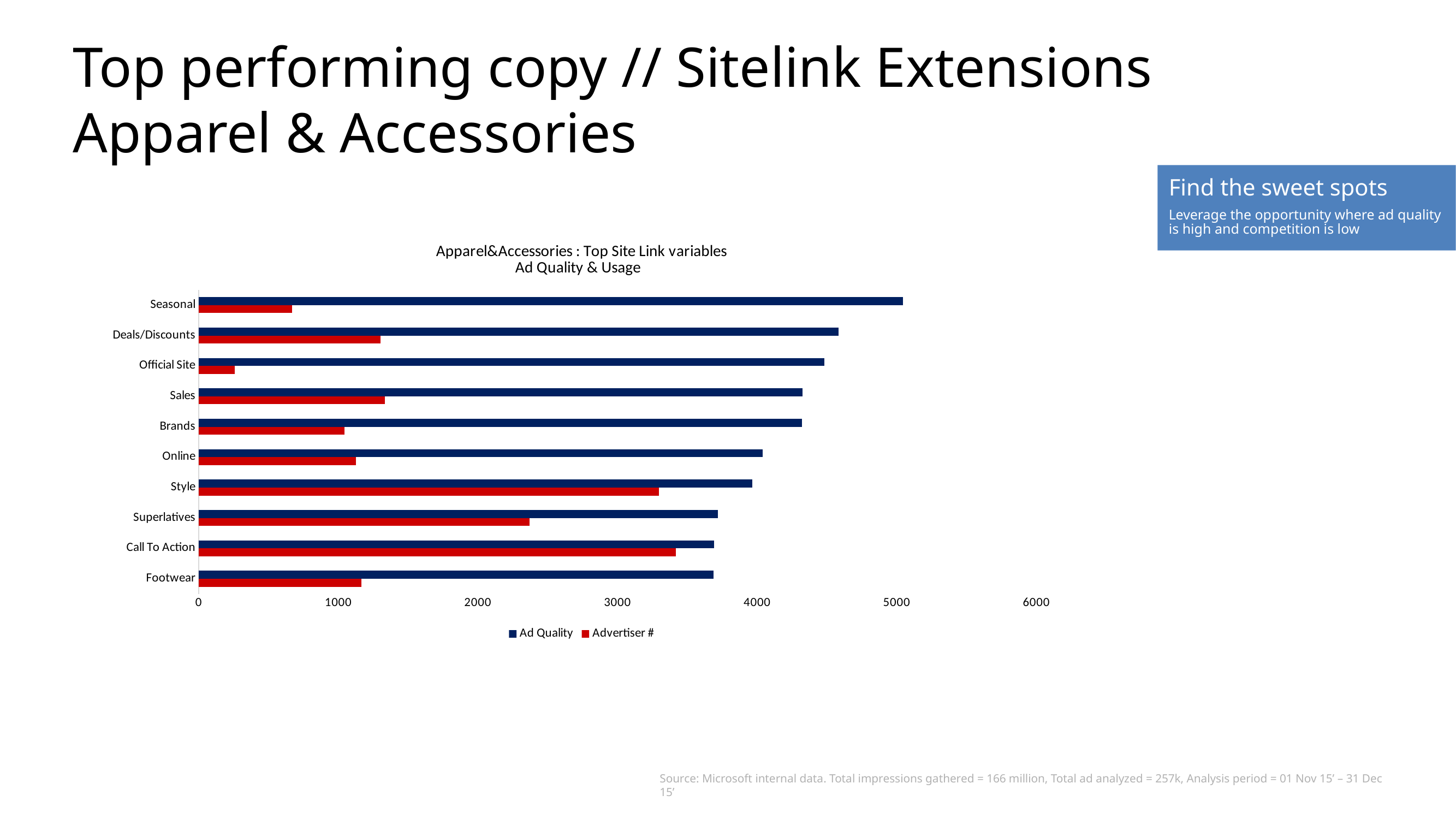
Is the Advertiser # value for Superlatives greater or less than 2000? greater Is the Advertiser # value for Seasonal greater or less than 1000? less How many series does the legend list? 2 Which category has the lowest Advertiser # value? Official Site Is the Ad Quality value for Deals/Discounts greater or less than 4000? greater What kind of chart is shown on the slide? Bar chart Which series is shown in red in the legend? Advertiser # How many categories are plotted on the chart? 10 Which category has the highest Ad Quality value? Seasonal Which is larger: the Advertiser # value for Style or for Seasonal? Style